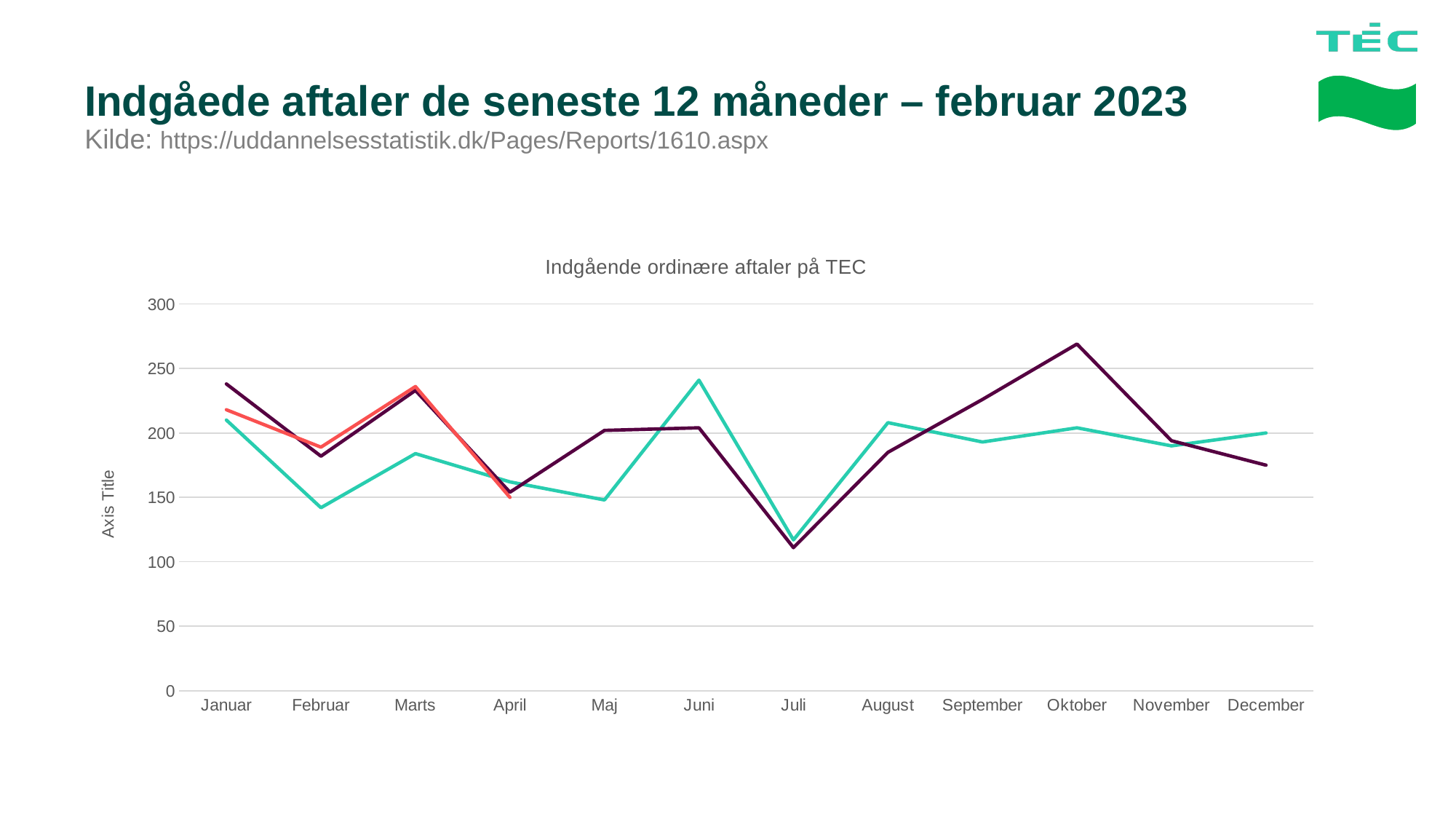
In which month does the dark purple line reach its highest value? Oktober What is the label on the vertical axis of the chart? Axis Title What is the title of the chart? Indgående ordinære aftaler på TEC What kind of chart is shown on the slide? Line chart Is the value of the dark purple line in Oktober greater or less than 250? greater In which month does the teal line reach its highest value? Juni Does the dark purple line rise or fall from Juli to Oktober? Rise How many months are shown on the x axis of the chart? 12 How many lines are plotted on the chart? 3 Is the value of the teal line in Februar greater or less than 150? less In Juni, which line has the higher value, the teal line or the dark purple line? The teal line In which month does the dark purple line reach its lowest value? Juli